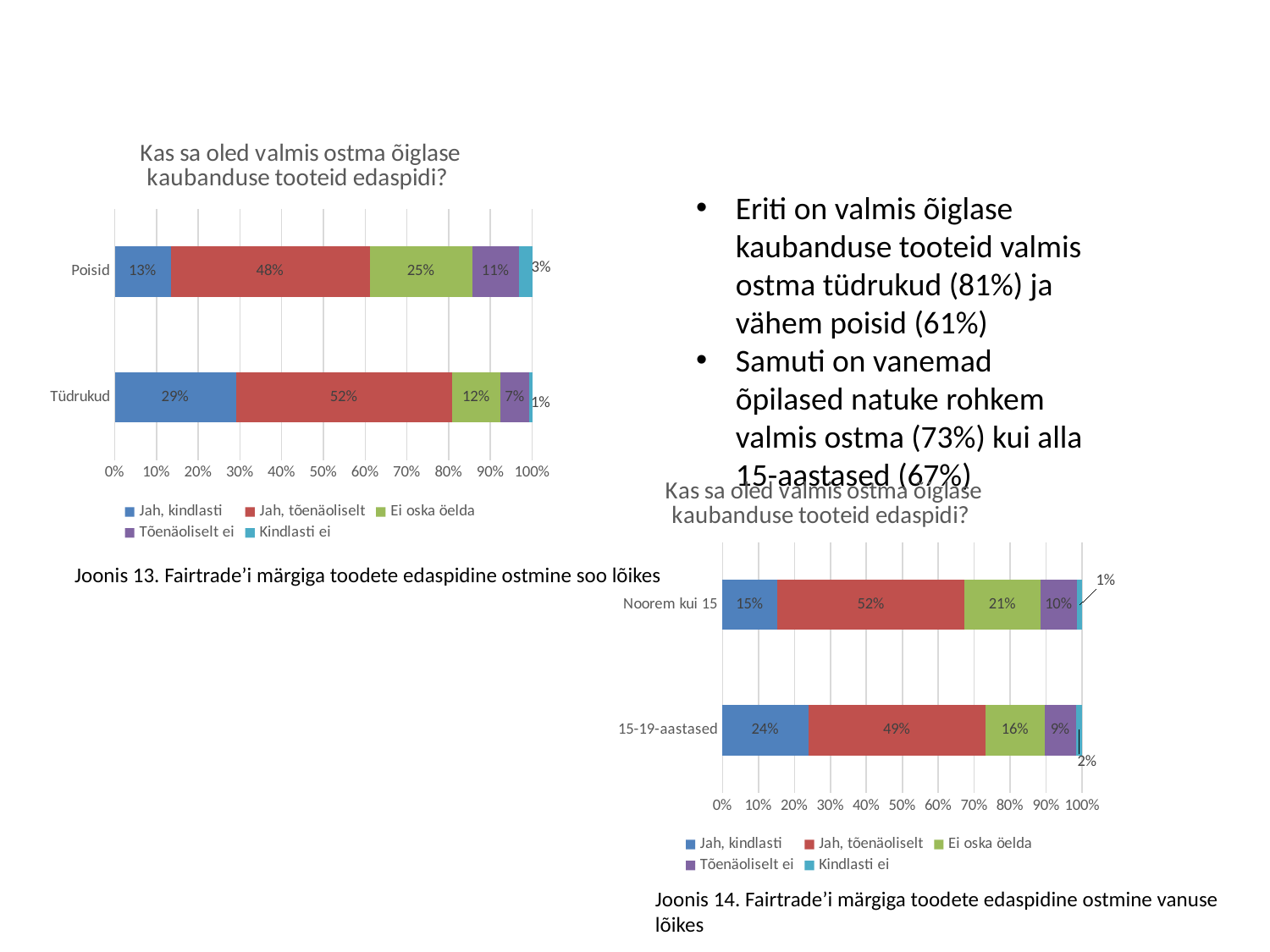
In the right chart (Joonis 14), what is the value of "Jah, kindlasti" for 15-19-aastased? 24% In the left chart (Joonis 13), which category has the larger "Tõenäoliselt ei" value, Poisid or Tüdrukud? Poisid In the left chart (Joonis 13), what is the value of "Ei oska öelda" for Poisid? 25% In the right chart (Joonis 14), what is the difference between the "Jah, kindlasti" values for 15-19-aastased and Noorem kui 15? 9% In the right chart (Joonis 14), what is the value of "Kindlasti ei" for 15-19-aastased? 2% In the left chart (Joonis 13), what is the value of "Jah, kindlasti" for Tüdrukud? 29% In the right chart (Joonis 14), which category has the larger "Jah, tõenäoliselt" value, Noorem kui 15 or 15-19-aastased? Noorem kui 15 How many series does the legend of the left chart (Joonis 13) list? 5 What kind of chart is the right chart (Joonis 14)? Stacked bar chart In the left chart (Joonis 13), what is the difference between the "Jah, tõenäoliselt" values for Tüdrukud and Poisid? 4% In the right chart (Joonis 14), what is the value of "Ei oska öelda" for Noorem kui 15? 21% In the left chart (Joonis 13), what is the value of "Kindlasti ei" for Poisid? 3%